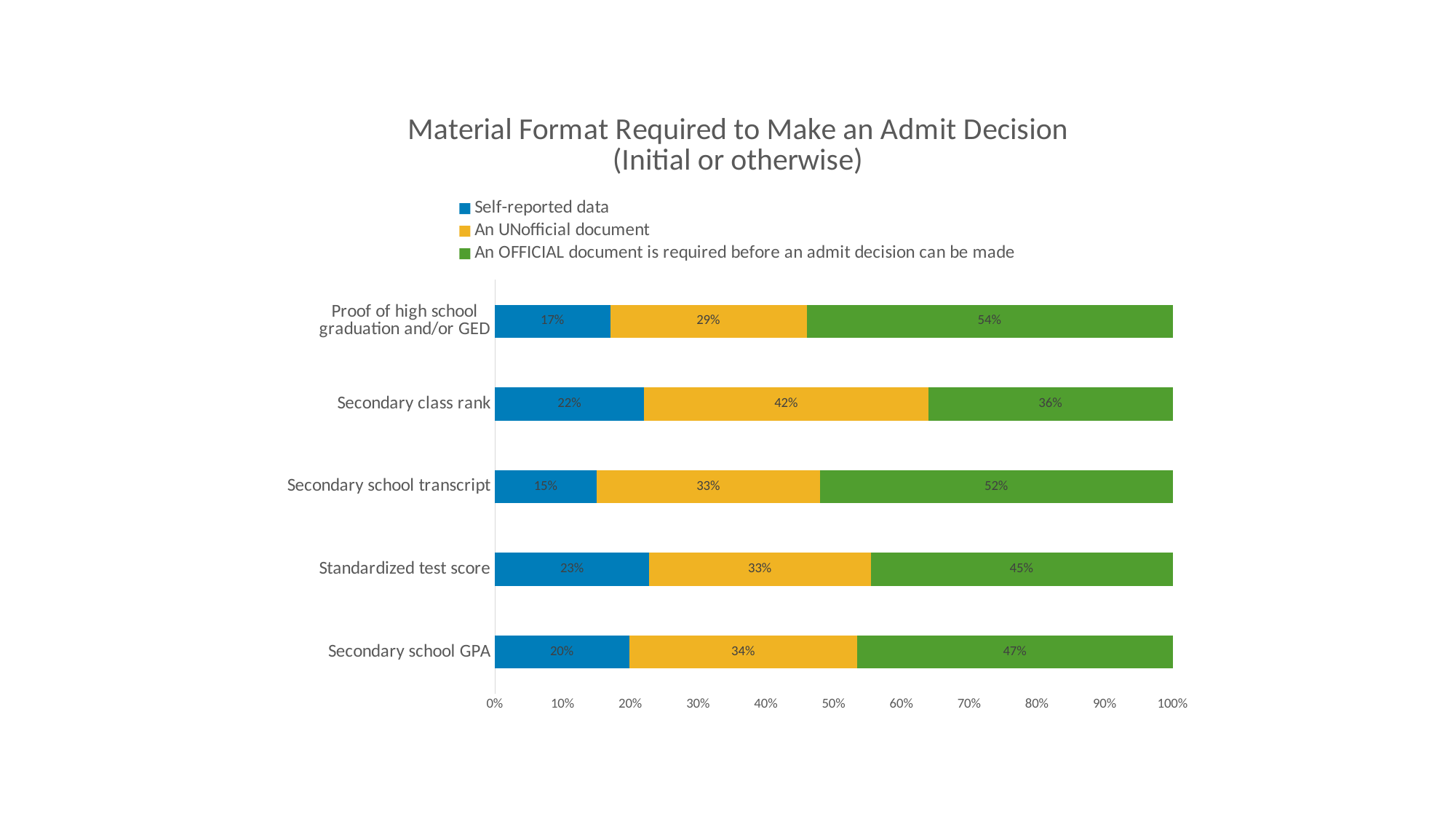
Which is larger: the UNofficial document value for Secondary class rank or for Proof of high school graduation and/or GED? Secondary class rank Which category has the highest value for An OFFICIAL document is required before an admit decision can be made? Proof of high school graduation and/or GED What is the Self-reported data value for Standardized test score? 23% What is the difference between the OFFICIAL document values for Secondary school transcript and Secondary class rank? 16% What colour represents Self-reported data in the chart? Blue Which category has the lowest Self-reported data value? Secondary school transcript How many series does the legend list? 3 What is the value for An UNofficial document for Secondary school GPA? 34% How many categories are shown on the chart? 5 What kind of chart is shown on the slide? Stacked bar chart What is the total of the stacked bar for Standardized test score? 101% What percentage of respondents require an OFFICIAL document for Secondary class rank? 36%